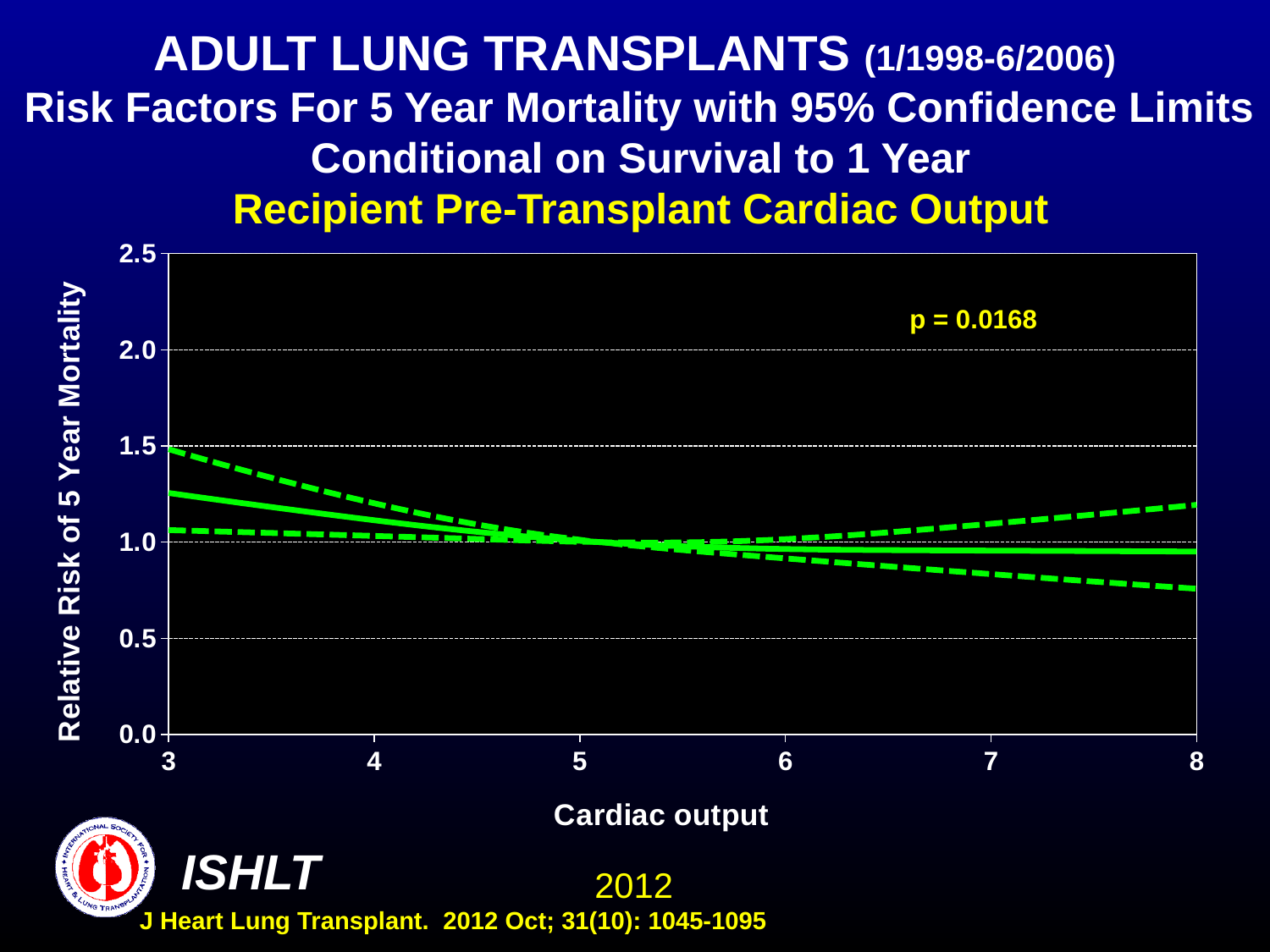
Is the lower 95% confidence limit (lower dashed line) at a cardiac output of 8 greater or less than 0.5? greater Is the relative risk (solid line) at a cardiac output of 3 greater or less than 1.5? less What kind of chart is shown on the slide? line chart Is the relative risk (solid line) higher at a cardiac output of 3 or at a cardiac output of 8? 3 Is the upper 95% confidence limit (upper dashed line) at a cardiac output of 3 greater or less than 1.0? greater Does the solid relative-risk line rise or fall as cardiac output increases from 3 to 8? fall What is the label of the x axis? Cardiac output What is the p-value printed on the chart? p = 0.0168 How many lines are plotted on the chart? 3